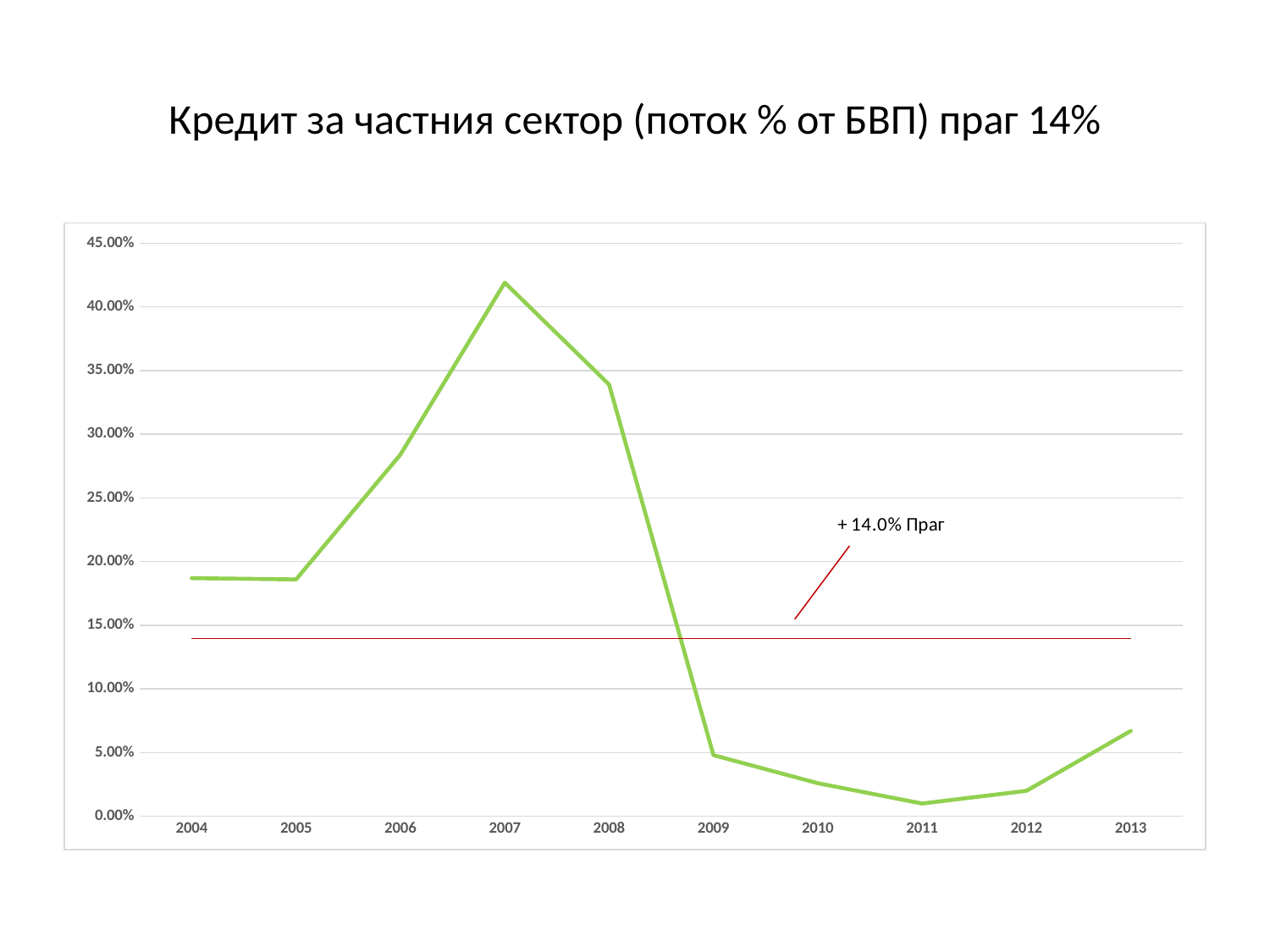
What threshold value is marked by the red horizontal line on the chart? 14.0% Which year has the highest value on the chart? 2007 Do the values rise or fall from 2007 to 2011? fall What kind of chart is shown on the slide? line chart How many years are plotted along the x axis? 10 Which year has the larger value, 2006 or 2008? 2008 Is the value for 2009 greater or less than 10.00%? less Is the value for 2008 greater or less than 30.00%? greater Is the value for 2007 greater or less than 40.00%? greater Which year has the lowest value on the chart? 2011 Which year has the larger value, 2009 or 2013? 2013